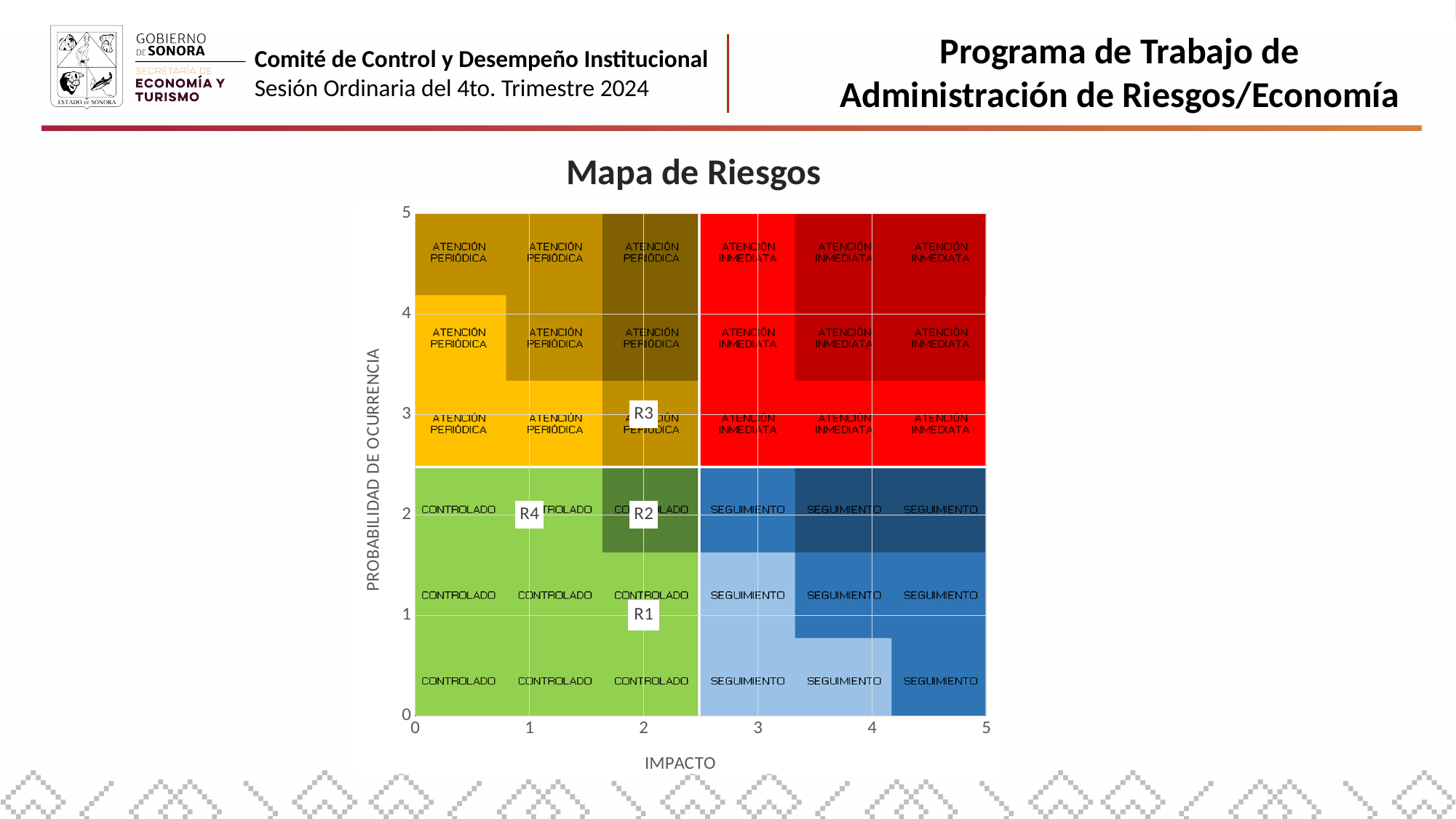
Is the probability of occurrence for R3 greater or less than 2? greater Which risk point has the lowest impact value? R4 What is the probability of occurrence value for R3? 3 What is the label of the horizontal axis? IMPACTO What is the impact value for R4? 1 Which risk point has the lowest probability of occurrence? R1 Which has a higher probability of occurrence, R2 or R1? R2 How many risk points (R labels) are plotted on the chart? 4 What is the impact value for R1? 2 What is the title of the chart? Mapa de Riesgos Which risk point has the highest probability of occurrence? R3 What is the difference in probability of occurrence between R3 and R1? 2